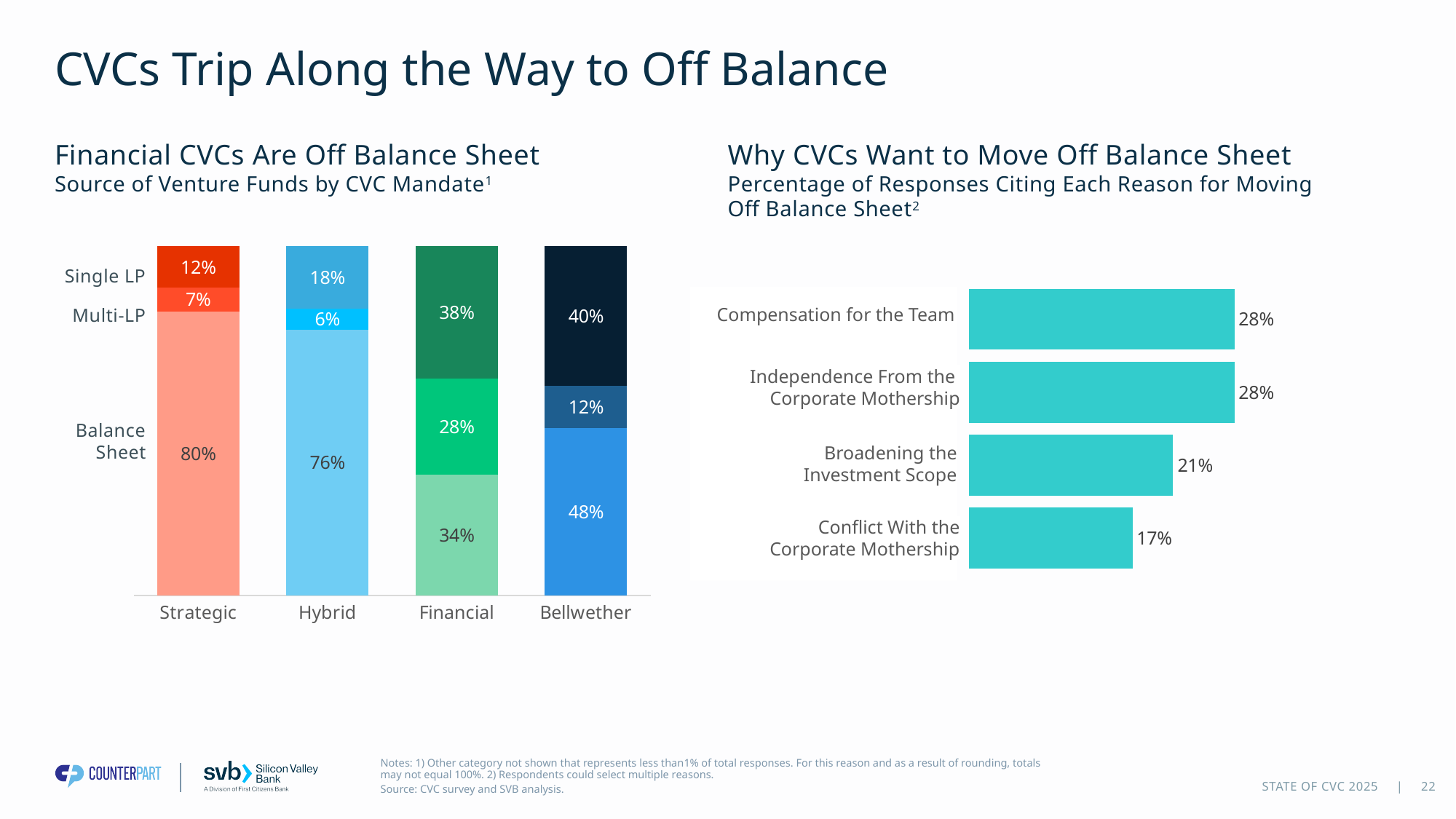
In the 'Financial CVCs Are Off Balance Sheet' chart, what is the Balance Sheet value for Strategic? 80% In the 'Financial CVCs Are Off Balance Sheet' chart, which mandate has the lowest Balance Sheet share? Financial In the 'Financial CVCs Are Off Balance Sheet' chart, what is the Multi-LP value for Hybrid? 6% In the 'Why CVCs Want to Move Off Balance Sheet' chart, which reason has the lowest percentage? Conflict With the Corporate Mothership What kind of chart is 'Financial CVCs Are Off Balance Sheet'? Stacked bar chart In the 'Why CVCs Want to Move Off Balance Sheet' chart, what percentage of responses cite Broadening the Investment Scope? 21% In the 'Financial CVCs Are Off Balance Sheet' chart, what is the total of the three segments for the Bellwether bar? 100% In the 'Why CVCs Want to Move Off Balance Sheet' chart, what is the difference between Compensation for the Team and Conflict With the Corporate Mothership? 11% In the 'Financial CVCs Are Off Balance Sheet' chart, what is the difference between the Balance Sheet values for Strategic and Financial? 46% In the 'Financial CVCs Are Off Balance Sheet' chart, what is the Single LP value for Bellwether? 40% How many mandate categories are shown in the 'Financial CVCs Are Off Balance Sheet' chart? 4 In the 'Financial CVCs Are Off Balance Sheet' chart, which is larger: the Single LP value for Financial or the Single LP value for Hybrid? Financial